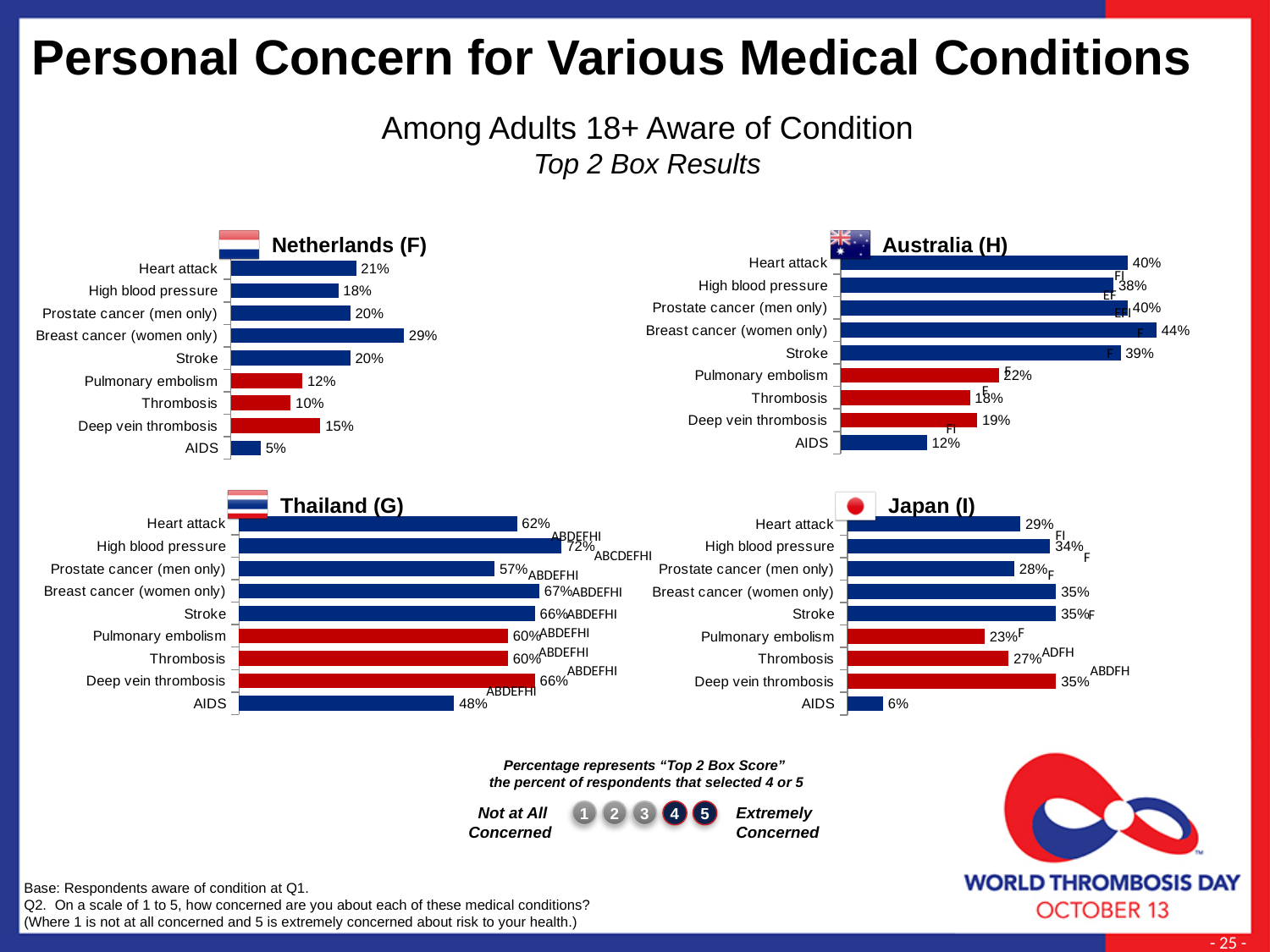
In the Japan (I) chart, what is the difference between the values for High blood pressure and Pulmonary embolism? 11% In the Netherlands (F) chart, what is the value for Breast cancer (women only)? 29% How many conditions are listed in the Australia (H) chart? 9 In the Thailand (G) chart, which condition has the highest value? High blood pressure In the Australia (H) chart, which condition has the highest value? Breast cancer (women only) In the Netherlands (F) chart, which condition has the lowest value? AIDS In the Thailand (G) chart, what is the value for AIDS? 48% In the Japan (I) chart, what is the value for Deep vein thrombosis? 35% In the Netherlands (F) chart, which is larger, the value for Thrombosis or the value for Deep vein thrombosis? Deep vein thrombosis In the Australia (H) chart, what is the value for Pulmonary embolism? 22% In the Japan (I) chart, what is the difference between the values for Stroke and AIDS? 29% What kind of chart is the Thailand (G) chart? Bar chart